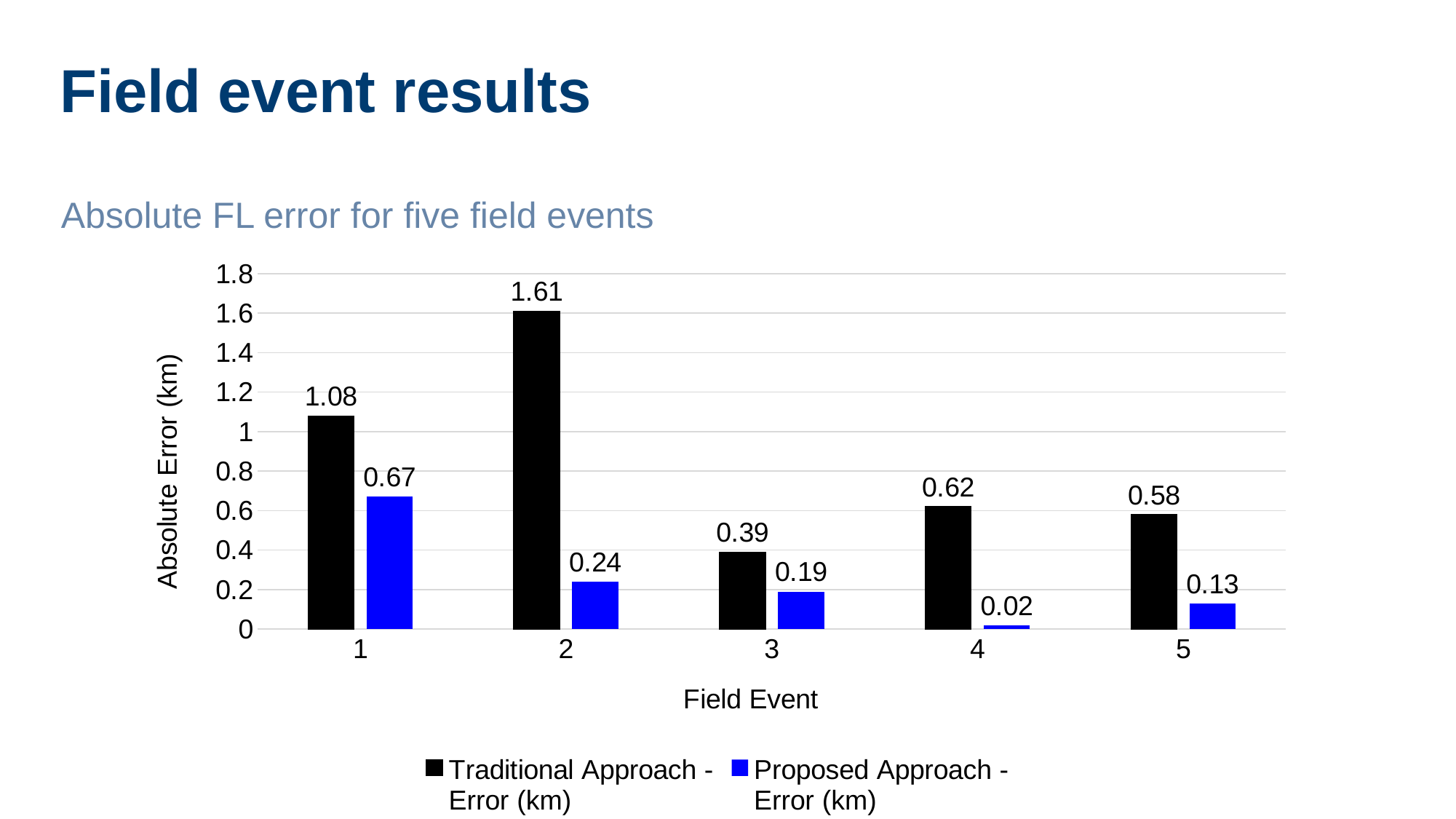
What is the difference between the Traditional and Proposed Approach errors for field event 1? 0.41 What is the Traditional Approach error for field event 2? 1.61 How many field events are shown on the x axis? 5 What is the label of the y axis? Absolute Error (km) What is the Proposed Approach error for field event 1? 0.67 Which colour represents the Proposed Approach series? Blue Which is larger for field event 3: the Traditional Approach error or the Proposed Approach error? Traditional Approach error Which field event has the highest Traditional Approach error? 2 How many series does the legend list? 2 What is the Proposed Approach error for field event 4? 0.02 What kind of chart is shown on the slide? Bar chart Which field event has the lowest Proposed Approach error? 4